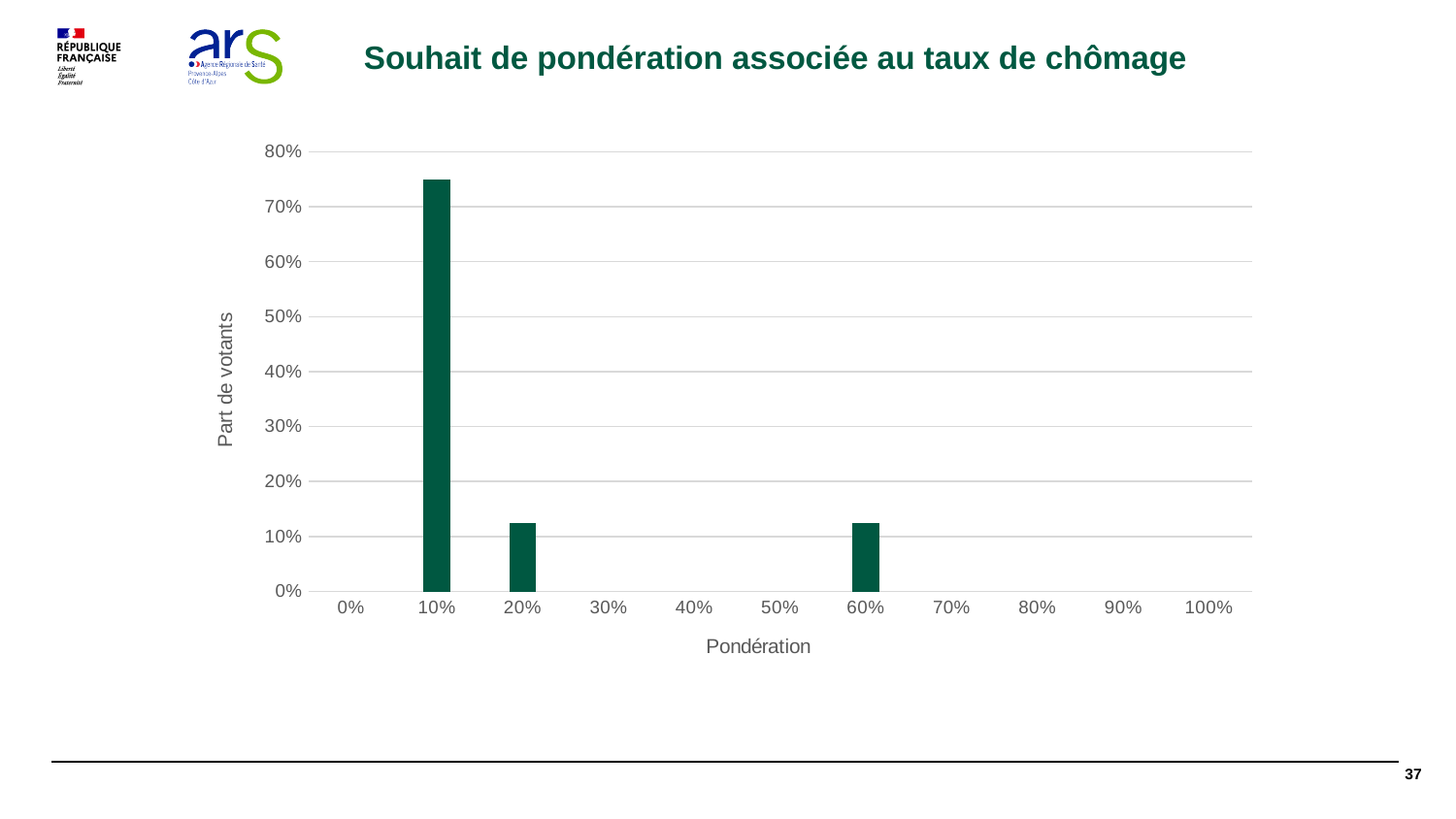
What is the label of the y axis? Part de votants Which has a larger share of voters: the 60% pondération or the 10% pondération? 10% Is the share of voters for the 20% pondération greater or less than 20%? less What kind of chart is shown on the slide? bar chart Which pondération value has the highest share of voters? 10% How many pondération values have a non-zero share of voters? 3 Is the share of voters for the 10% pondération greater or less than 70%? greater What is the title of the chart? Souhait de pondération associée au taux de chômage Is the share of voters for the 60% pondération greater or less than 20%? less Which has a larger share of voters: the 10% pondération or the 20% pondération? 10% How many pondération categories are shown on the x axis? 11